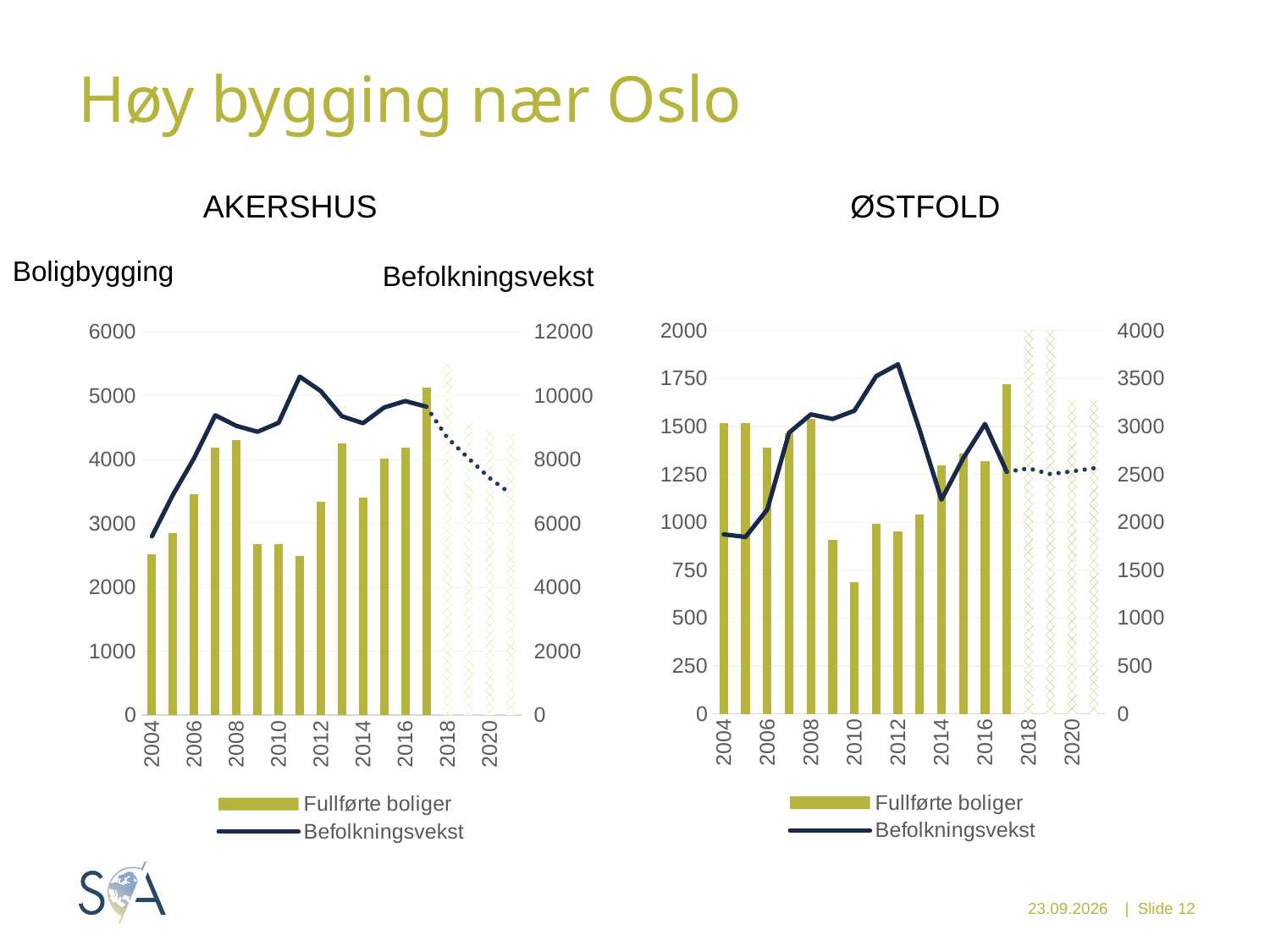
On the ØSTFOLD chart, which year has the larger Fullførte boliger bar, 2010 or 2011? 2011 What kind of chart is the AKERSHUS chart? bar chart with a line On the ØSTFOLD chart, which year has the tallest Fullførte boliger bar? 2017 On the ØSTFOLD chart, which year has the lowest Fullførte boliger bar? 2010 On the AKERSHUS chart, which year has the tallest Fullførte boliger bar? 2017 On the AKERSHUS chart, which year has the larger Fullførte boliger bar, 2004 or 2017? 2017 On the AKERSHUS chart, is the Fullførte boliger value for 2008 greater or less than 4000? greater On the AKERSHUS chart, does the Befolkningsvekst line rise or fall from 2004 to 2007? rise On the ØSTFOLD chart, is the Fullførte boliger value for 2010 greater or less than 750? less On the AKERSHUS chart, is the Fullførte boliger value for 2004 greater or less than 3000? less How many series does the legend of the ØSTFOLD chart list? 2